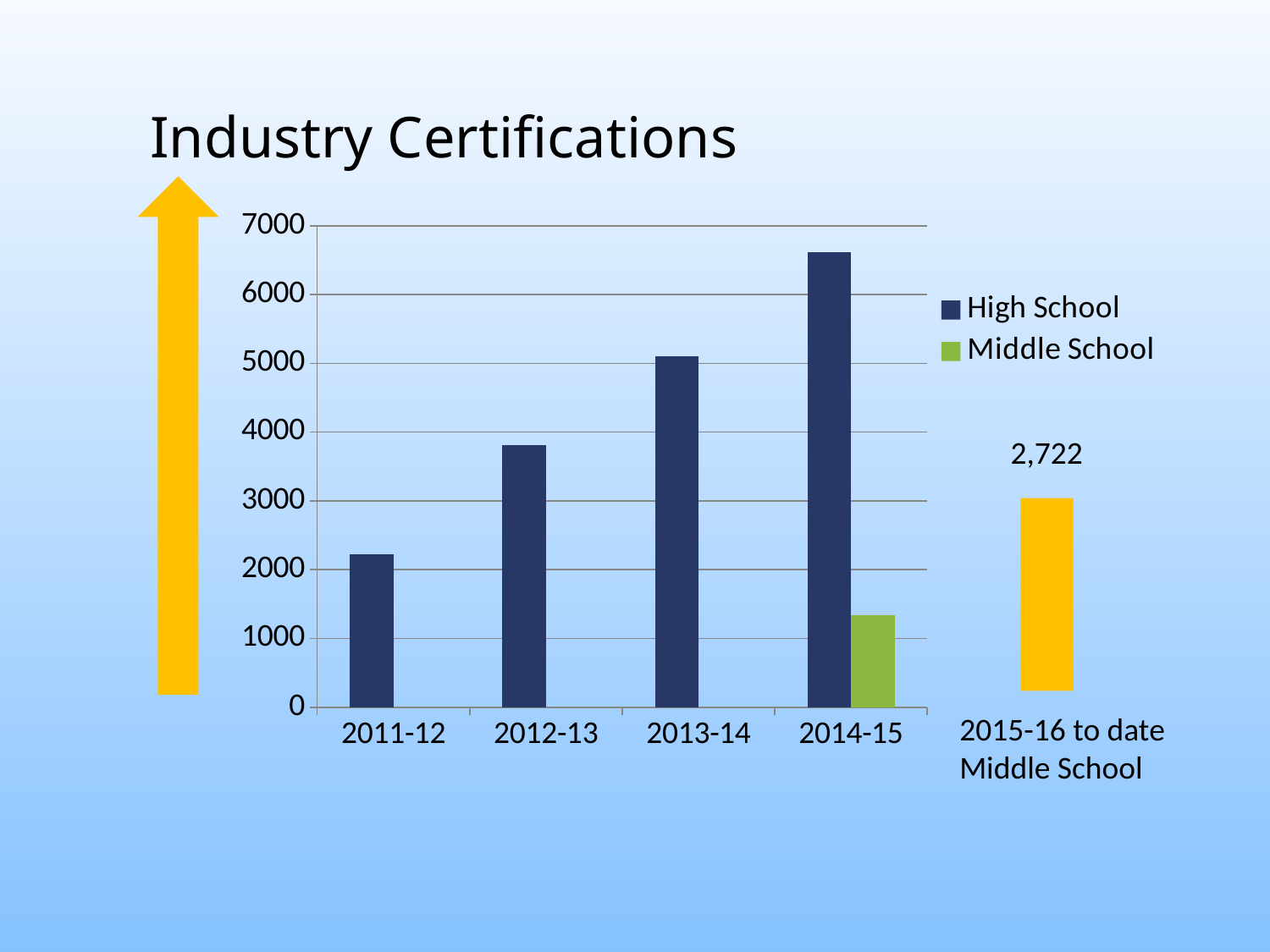
What is the title of the chart? Industry Certifications Which school year has the highest High School value? 2014-15 Do the High School values rise or fall from 2011-12 to 2014-15? rise Is the High School value for 2012-13 greater or less than 3000? greater What kind of chart is shown on the slide? bar chart Which is larger, the High School value for 2012-13 or for 2013-14? 2013-14 How many school-year categories are shown on the x axis of the chart? 4 Is the Middle School value for 2014-15 greater or less than 2000? less Is the High School value for 2011-12 greater or less than 3000? less How many series does the legend list? 2 Which school year has the lowest High School value? 2011-12